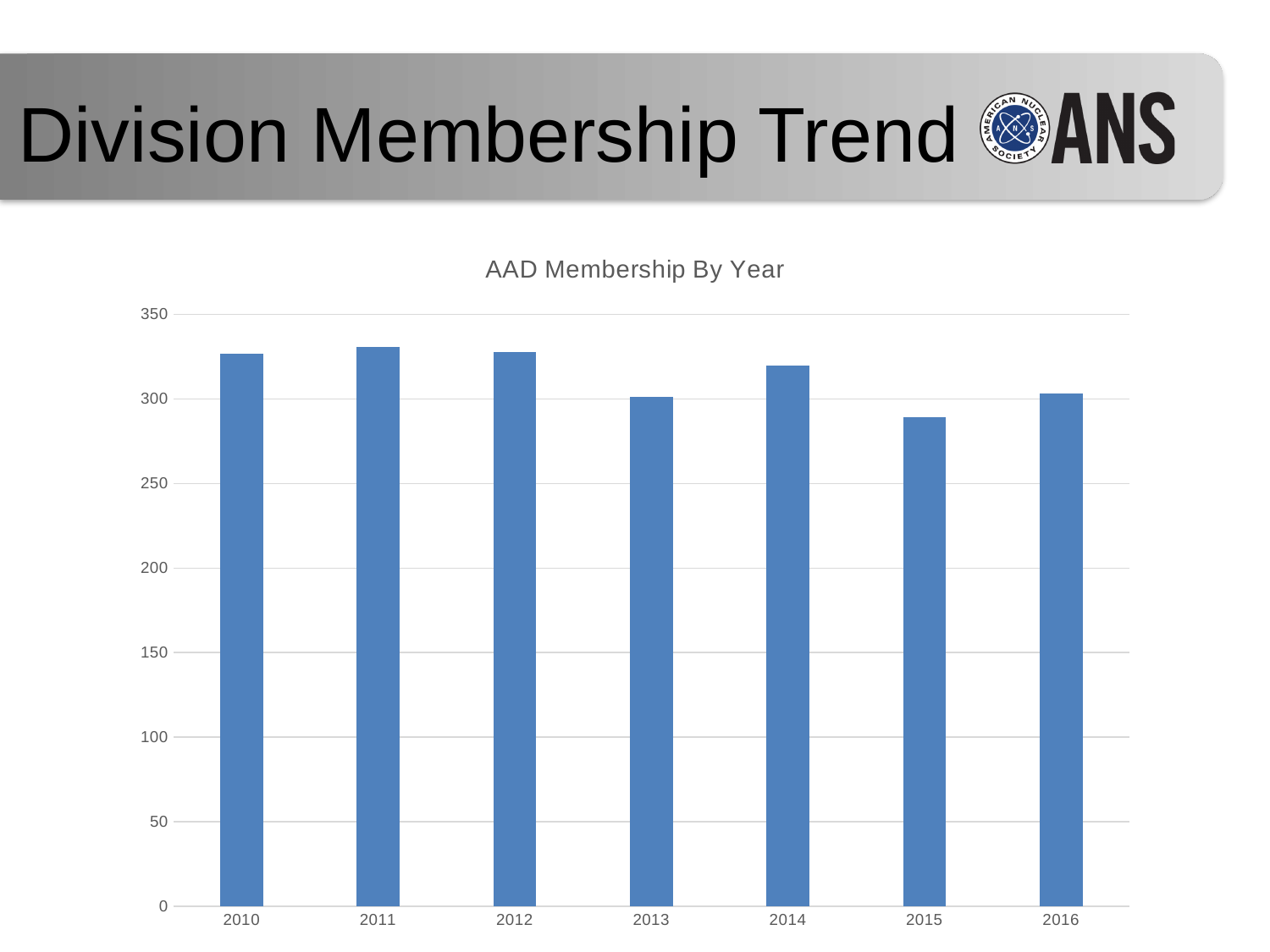
Does membership rise or fall from 2015 to 2016? rise How many years are shown on the x axis of the chart? 7 Does membership rise or fall from 2014 to 2015? fall Is the value for 2014 greater or less than 300? greater What kind of chart is shown on the slide? bar chart Is the value for 2011 greater or less than 350? less What is the title of the chart? AAD Membership By Year Which year has the lowest membership in the chart? 2015 Is the value for 2015 greater or less than 300? less Which year has the larger membership, 2010 or 2013? 2010 Which year has the larger membership, 2014 or 2015? 2014